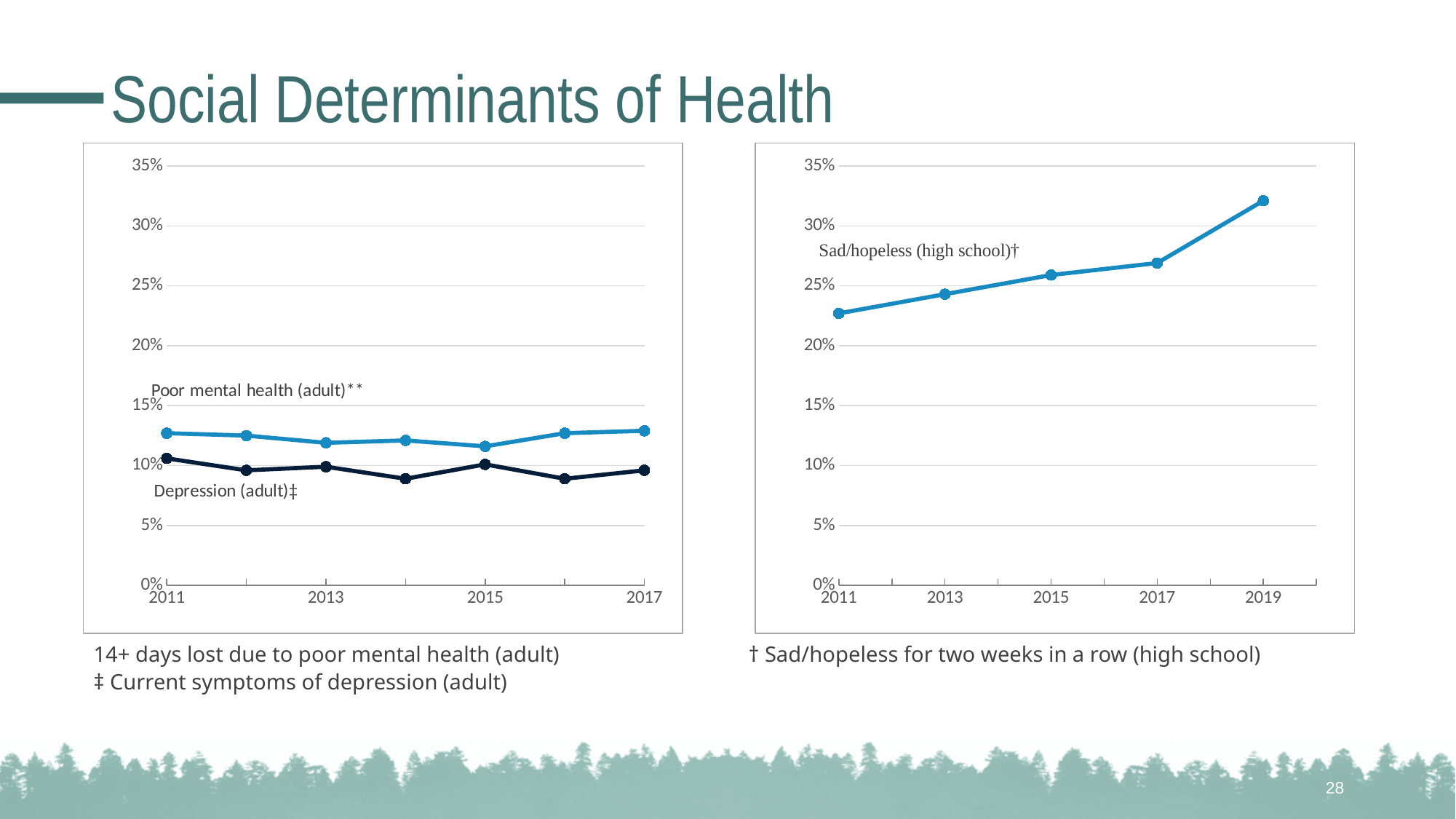
What is the label of the series plotted on the right chart? Sad/hopeless (high school)† On the left chart, which series is higher in 2017, Poor mental health (adult) or Depression (adult)? Poor mental health (adult) How many series are plotted on the left chart? 2 On the right chart, is the value for Sad/hopeless (high school) in 2019 greater or less than 30%? greater What kind of chart is the left chart (Poor mental health / Depression)? line chart On the left chart, is the value for Poor mental health (adult) in 2015 greater or less than 15%? less On the right chart (Sad/hopeless), how many data points are plotted? 5 On the left chart, how many data points does the Poor mental health (adult) line have? 7 On the right chart, is the value for Sad/hopeless (high school) in 2011 greater or less than 25%? less On the right chart, do the Sad/hopeless (high school) values rise or fall from 2011 to 2019? rise On the right chart, which year has the highest Sad/hopeless (high school) value? 2019